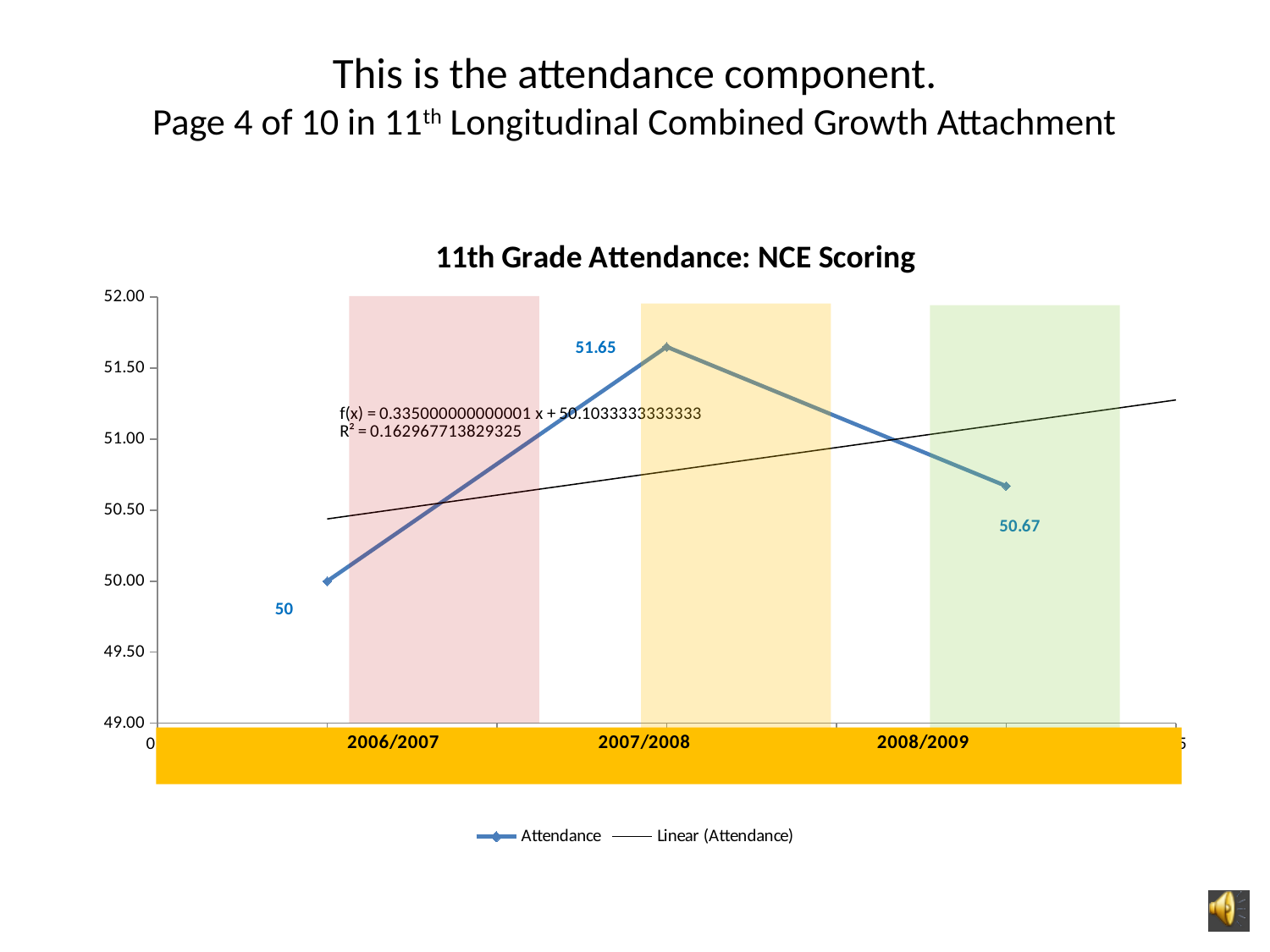
Which is larger, the Attendance value for 2008/2009 or for 2006/2007? 2008/2009 What is the Attendance value for 2008/2009? 50.67 How many entries does the legend list? 2 What is the Attendance value for 2006/2007? 50 How many data points are plotted on the Attendance line? 3 What is the Attendance value for 2007/2008? 51.65 What is the title of the chart? 11th Grade Attendance: NCE Scoring What is the difference between the Attendance values for 2007/2008 and 2006/2007? 1.65 Which year has the highest Attendance value? 2007/2008 Which year has the lowest Attendance value? 2006/2007 What type of chart is shown on the slide? line chart What is the difference between the Attendance values for 2007/2008 and 2008/2009? 0.98